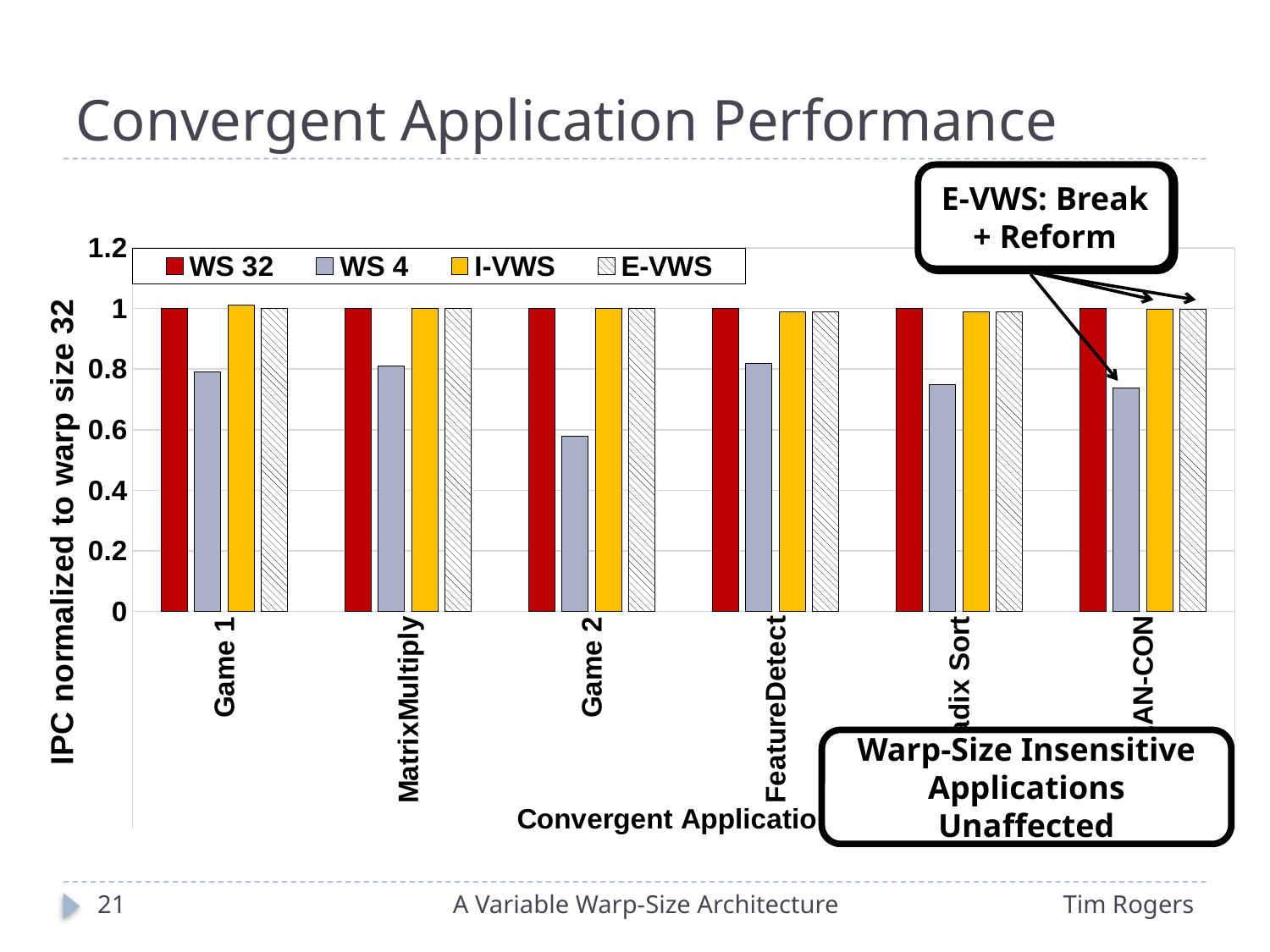
How many series does the legend list? 4 Which application has the lowest WS 4 value? Game 2 Which application has the larger WS 4 value: Game 2 or FeatureDetect? FeatureDetect Which is larger for Game 2: the WS 32 value or the WS 4 value? WS 32 What kind of chart is shown on the slide? bar chart Is the WS 4 value for MatrixMultiply greater or less than 0.6? greater How many application categories are plotted along the x axis? 6 Is the WS 4 value for Game 2 greater or less than 0.8? less Is the WS 4 value for Game 1 greater or less than 1? less What is the WS 32 value for Game 1? 1 What is the title of the y axis? IPC normalized to warp size 32 What is the WS 32 value for FeatureDetect? 1